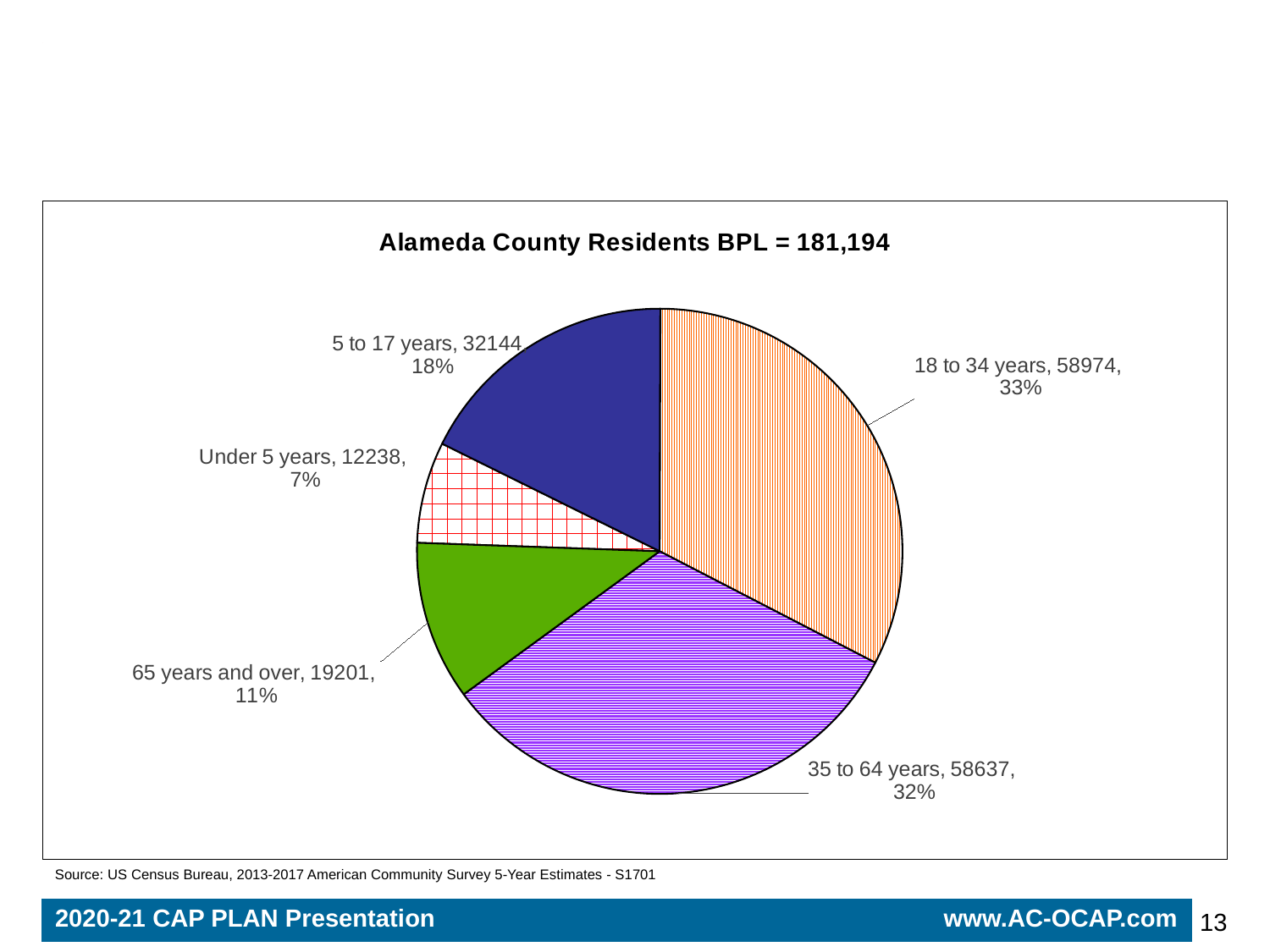
What is the difference between the 65 years and over value and the Under 5 years value? 6963 Which age group has the smallest number of residents? Under 5 years Which age group has the largest number of residents? 18 to 34 years What share of the pie does the Under 5 years slice represent? 7% What is the difference between the 18 to 34 years value and the 35 to 64 years value? 337 How many age groups (slices) does the pie chart show? 5 What type of chart is shown on the slide? Pie chart Which is larger, the value for 5 to 17 years or the value for 65 years and over? 5 to 17 years How many residents are in the 18 to 34 years group? 58974 What is the value for the 5 to 17 years group? 32144 What is the title of the chart? Alameda County Residents BPL = 181,194 What percentage of the pie is the 35 to 64 years slice? 32%